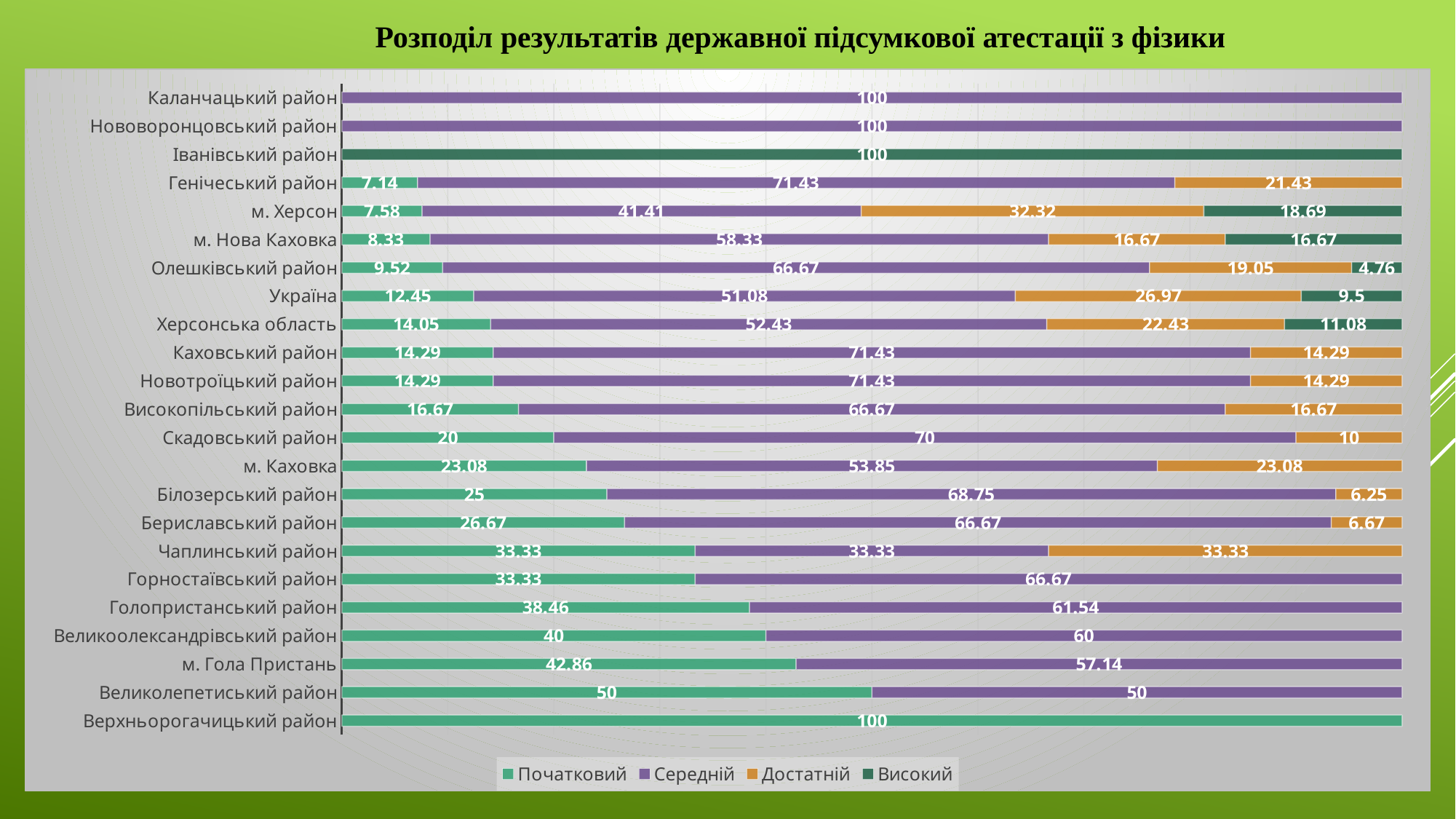
What is the value of the Високий series for Україна? 9.5 What is the value of the Високий series for Олешківський район? 4.76 How many categories are shown on the chart? 23 What is the total of the stacked bar for м. Нова Каховка? 100 Which has a larger Початковий value: м. Каховка or Білозерський район? Білозерський район What is the value of the Достатній series for м. Херсон? 32.32 What is the difference between the Середній and Початковий values for Херсонська область? 38.38 What is the value of the Середній series for Скадовський район? 70 How many series does the legend list? 4 What kind of chart is shown on the slide? Stacked bar chart Which category has the highest value in the Початковий series? Верхньорогачицький район Which category has the highest value in the Високий series? Іванівський район